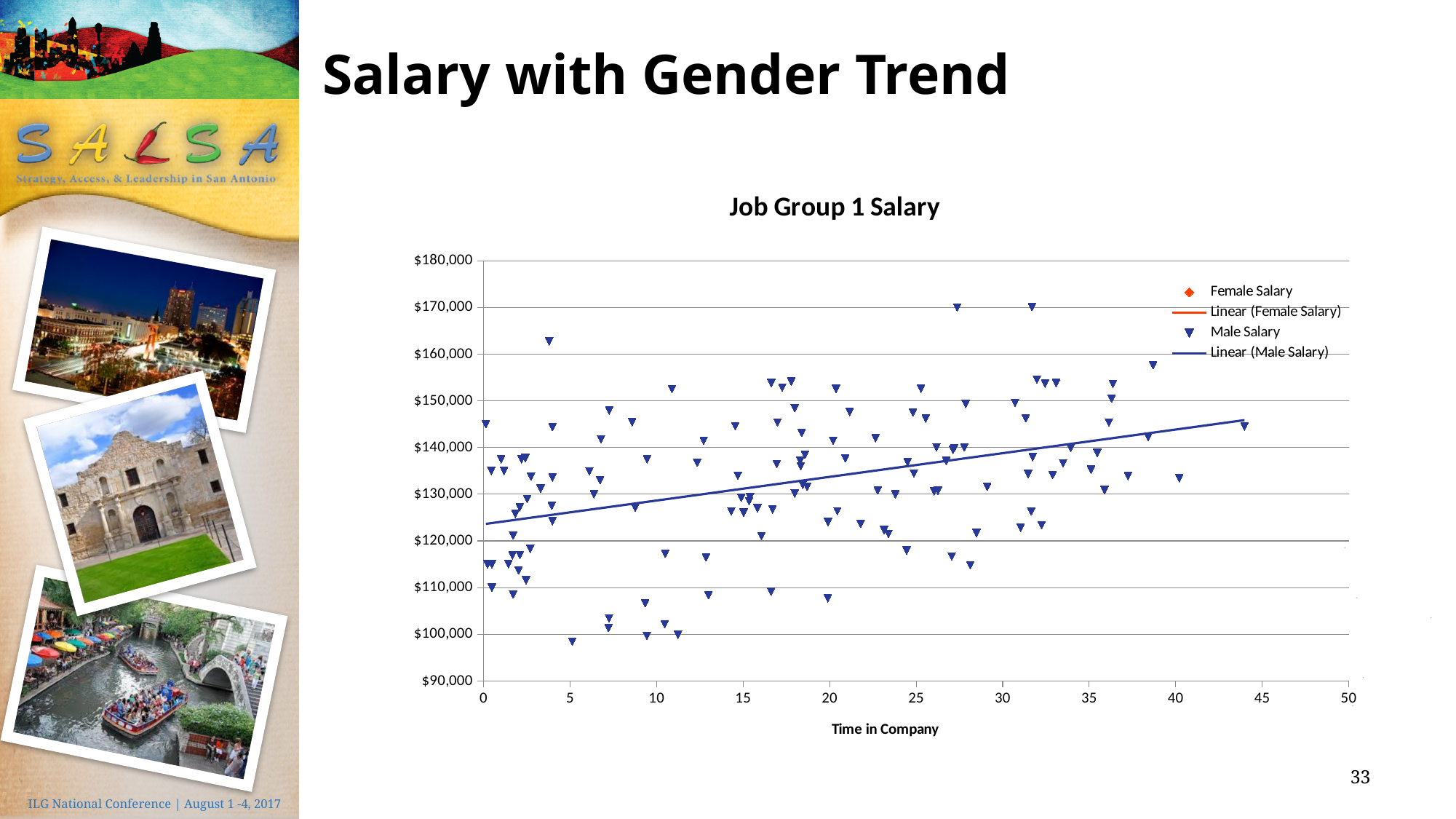
How many entries does the chart's legend list? 4 What is the label of the x axis? Time in Company What is the highest value shown on the y axis? $180,000 Does the Linear (Male Salary) trend line rise or fall as Time in Company increases? Rises What kind of chart is shown on the slide? Scatter chart What is the highest value shown on the x axis? 50 What is the lowest value shown on the y axis? $90,000 Is the Linear (Male Salary) trend line at Time in Company 0 greater or less than $130,000? less What is the title of the chart? Job Group 1 Salary Is the Linear (Male Salary) trend line at Time in Company 40 greater or less than $140,000? greater Is the highest Male Salary point greater or less than $160,000? greater